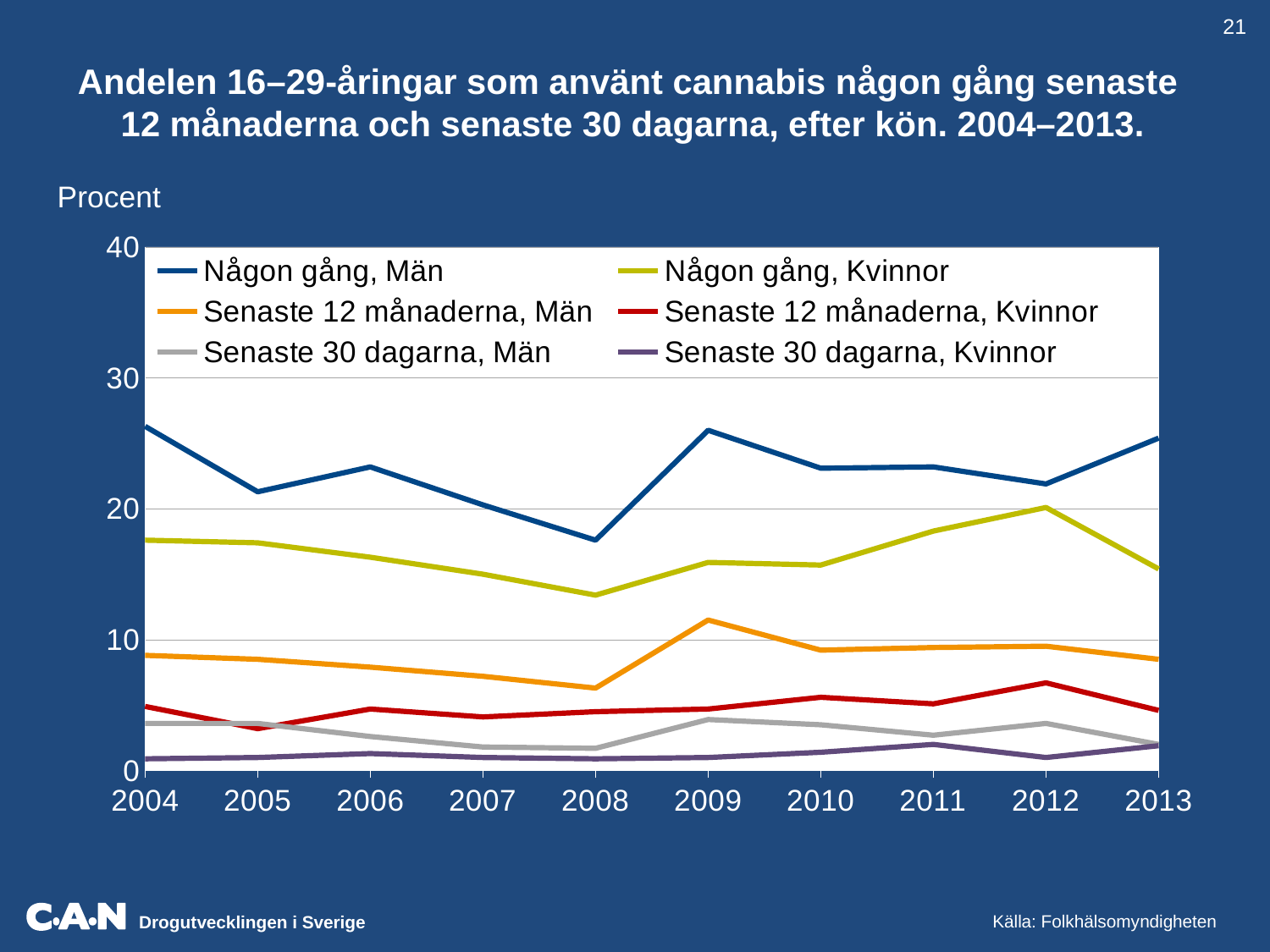
Does the "Någon gång, Män" series rise or fall from 2004 to 2008? Fall Is the value for "Någon gång, Kvinnor" in 2008 greater or less than 15? less Is the value for "Någon gång, Män" in 2008 greater or less than 20? less Is the value for "Senaste 12 månaderna, Män" in 2009 greater or less than 10? greater In 2013, which is larger: "Någon gång, Män" or "Någon gång, Kvinnor"? Någon gång, Män In which year is the "Senaste 12 månaderna, Män" series at its highest? 2009 What unit label is shown above the y axis? Procent How many series does the legend list? 6 How many years are plotted along the x axis? 10 In which year is the "Någon gång, Män" series at its lowest? 2008 In which year is the "Någon gång, Kvinnor" series at its highest? 2012 What kind of chart is shown on the slide? Line chart